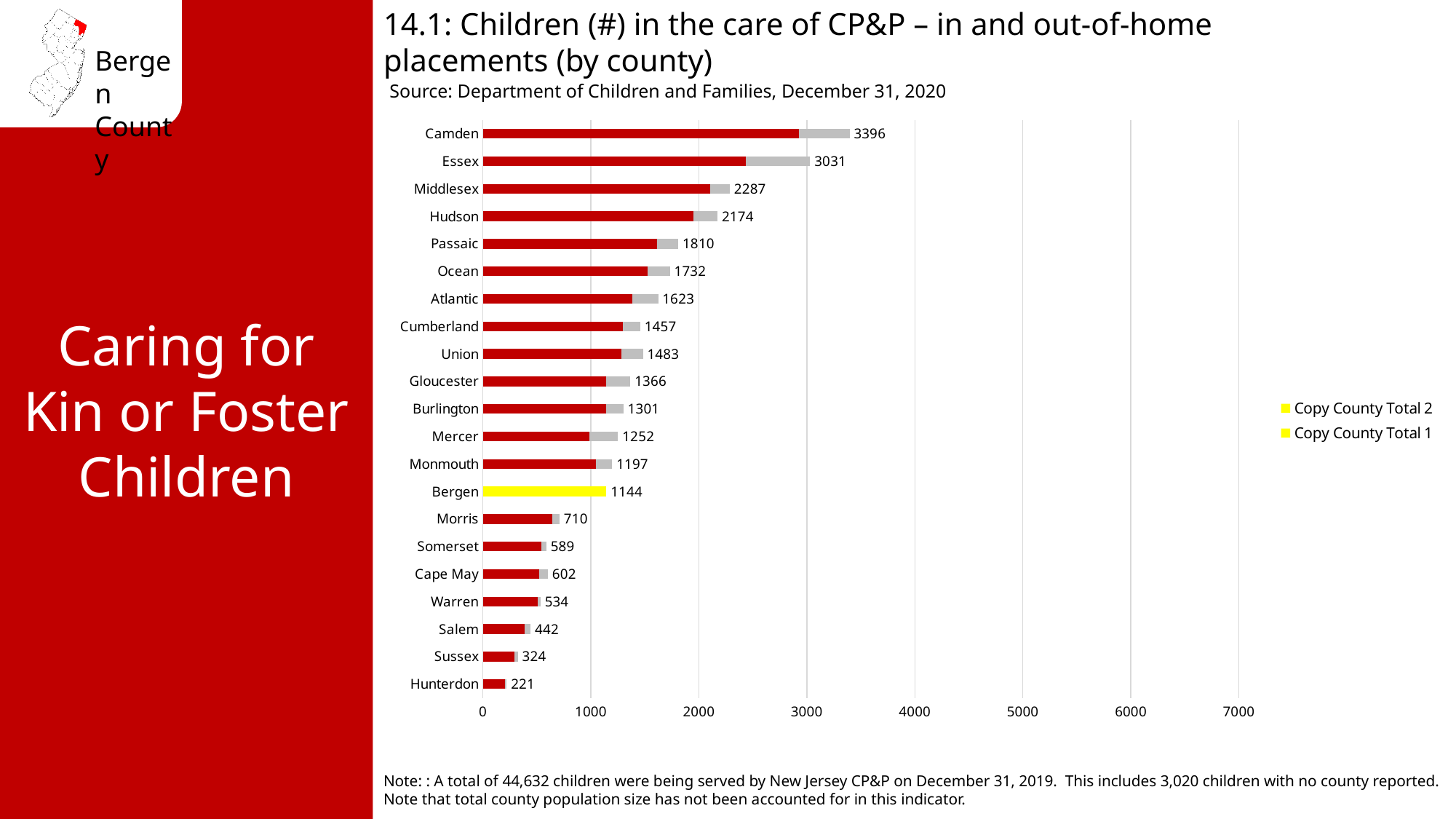
What kind of chart is shown on the slide? Bar chart What is the difference between the values for Bergen and Morris? 434 Which county has the highest number of children in the care of CP&P? Camden Which county has the lowest number of children in the care of CP&P? Hunterdon How many series does the legend list? 2 Which county has a larger value, Union or Cumberland? Union What is the value shown for Camden County? 3396 What is the difference between the values for Camden and Essex? 365 What is the value shown for Hunterdon County? 221 What is the total number of children in the care of CP&P shown for Bergen County? 1144 Is the value for Hudson greater or less than 2000? greater How many counties are shown on the chart? 21